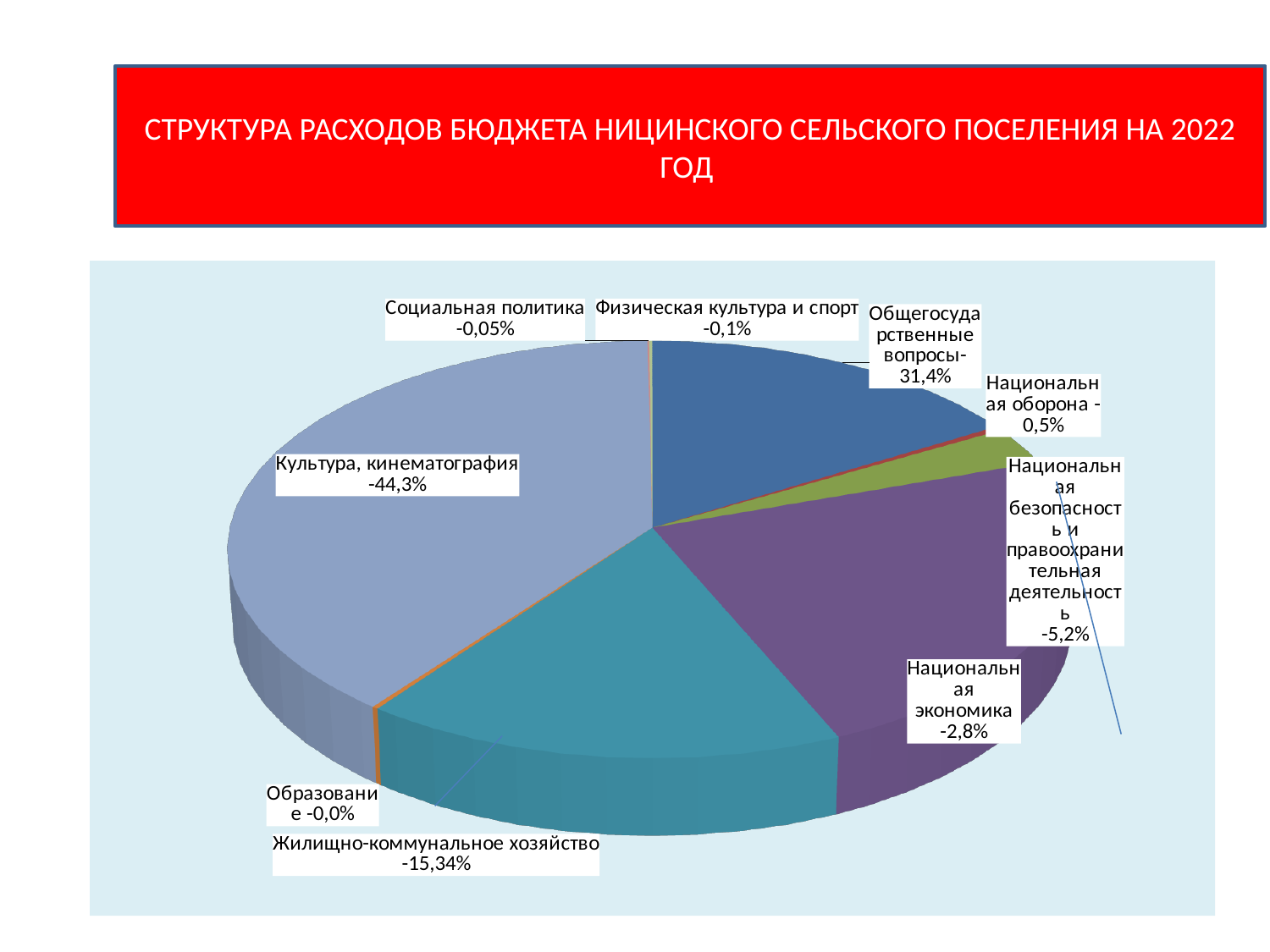
Which category has the smallest share shown on the chart? Образование Which category has the largest share of the budget expenditure? Культура, кинематография What is the title of the slide? СТРУКТУРА РАСХОДОВ БЮДЖЕТА НИЦИНСКОГО СЕЛЬСКОГО ПОСЕЛЕНИЯ НА 2022 ГОД Which is larger: the share for Национальная экономика or the share for Национальная безопасность и правоохранительная деятельность? Национальная безопасность и правоохранительная деятельность What type of chart is shown on the slide? Pie chart How many categories are shown on the pie chart? 9 What share of the budget expenditure is allocated to Культура, кинематография? 44,3% What percentage is shown for Жилищно-коммунальное хозяйство? 15,34% What is the value shown for Общегосударственные вопросы? 31,4% What is the difference between the shares of Культура, кинематография and Общегосударственные вопросы? 12,9% What share is shown for Национальная оборона? 0,5% What is the value for Национальная безопасность и правоохранительная деятельность? 5,2%